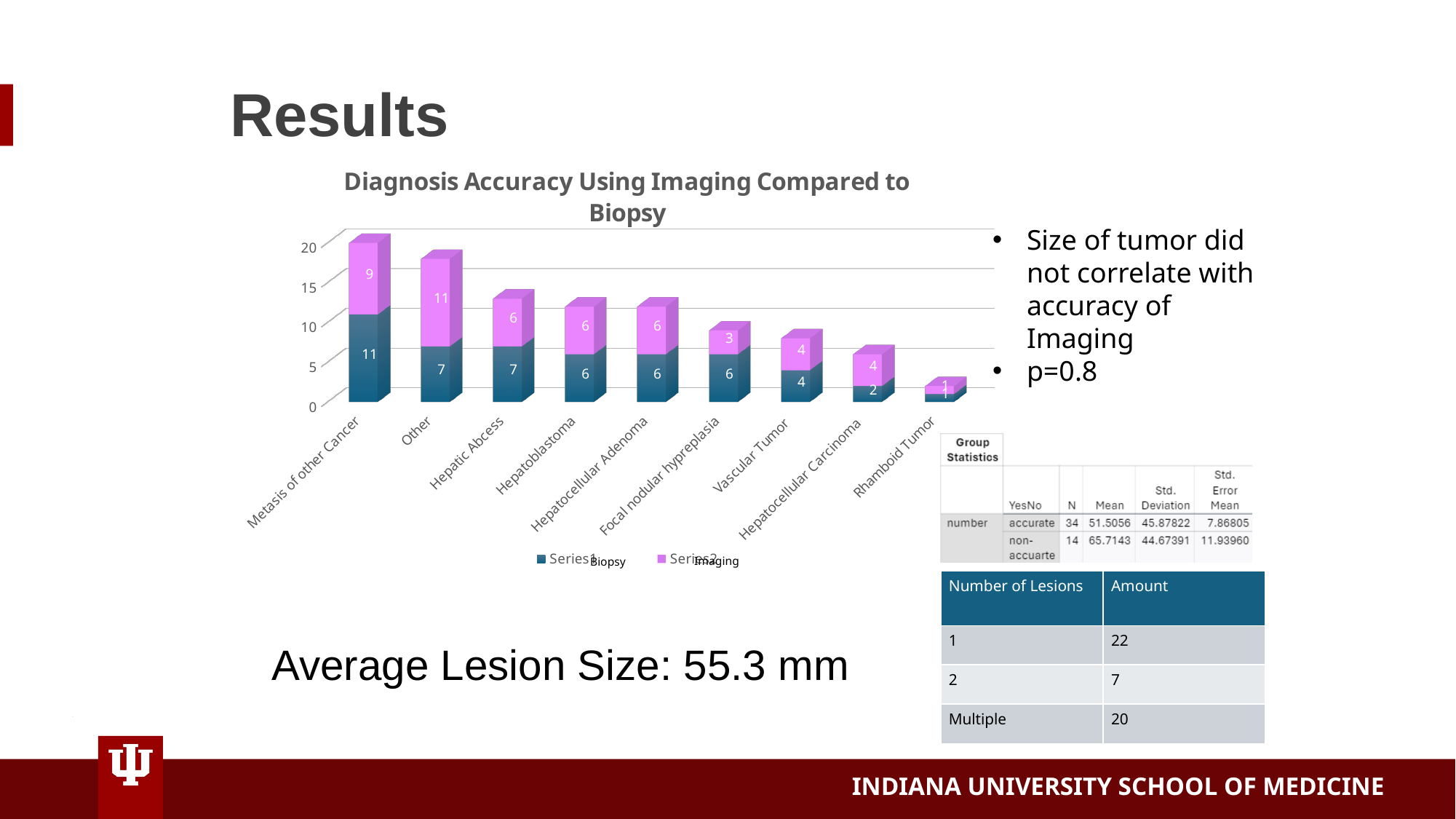
What is the total of the stacked bar for 'Other'? 18 What type of chart is shown under the title 'Diagnosis Accuracy Using Imaging Compared to Biopsy'? Stacked bar chart What is the Imaging (Series2) value for 'Other'? 11 How many categories are shown on the x axis of the 'Diagnosis Accuracy Using Imaging Compared to Biopsy' chart? 9 Which category has the highest Biopsy (Series1) value? Metasis of other Cancer What is the difference between the Biopsy (Series1) value for 'Metasis of other Cancer' and the Biopsy value for 'Vascular Tumor'? 7 What is the Biopsy (Series1) value for 'Hepatocellular Carcinoma'? 2 Which is larger: the Imaging (Series2) value for 'Hepatocellular Carcinoma' or the Imaging value for 'Rhamboid Tumor'? Hepatocellular Carcinoma What is the Imaging (Series2) value for 'Focal nodular hypreplasia'? 3 How many series does the legend of the 'Diagnosis Accuracy Using Imaging Compared to Biopsy' chart list? 2 What is the Biopsy (Series1) value for 'Metasis of other Cancer'? 11 Which category has the lowest total stacked bar? Rhamboid Tumor